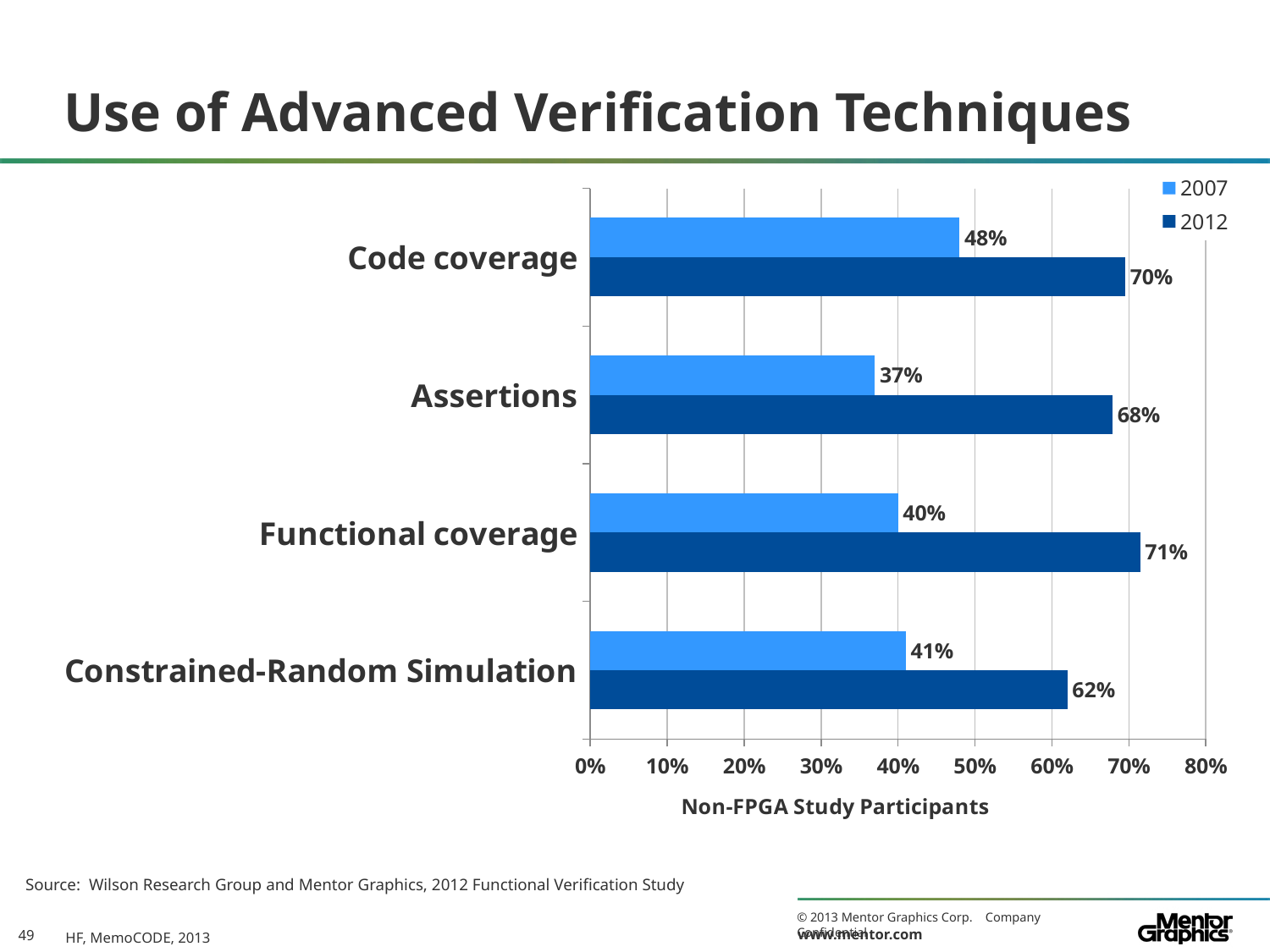
Which was larger in 2007: Code coverage or Functional coverage? Code coverage Which technique had the highest value in 2012? Functional coverage Which technique had the lowest value in 2007? Assertions By how many percentage points did the use of Assertions increase from 2007 to 2012? 31% What was the value for Constrained-Random Simulation in 2012? 62% What is the label on the horizontal axis of the chart? Non-FPGA Study Participants How many series does the legend list? 2 How many verification techniques are shown on the chart? 4 What was the value for Assertions in 2007? 37% What is the difference between the 2012 values for Functional coverage and Constrained-Random Simulation? 9% What percentage of non-FPGA study participants used code coverage in 2012? 70% What kind of chart is shown on the slide? Bar chart